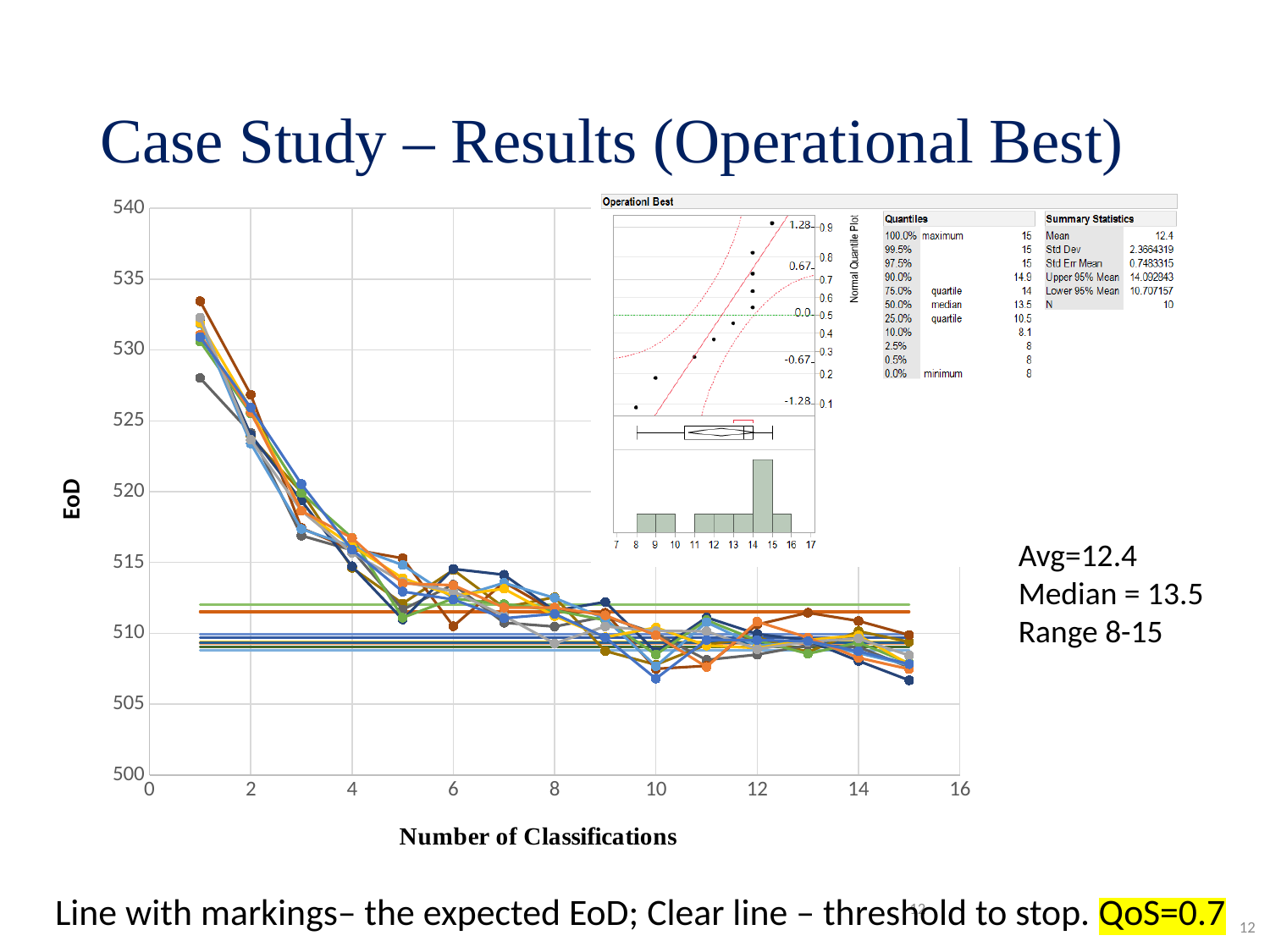
In the main chart, do the plotted EoD lines generally rise or fall as the Number of Classifications increases? fall In the main chart, what is the label of the y axis? EoD In the Operational Best quantiles panel, what is the 100.0% maximum value? 15 In the main chart, are the EoD values at Number of Classifications = 3 greater or less than 515? greater In the main chart, are the EoD values at Number of Classifications = 10 greater or less than 520? less What kind of chart is the main chart plotting EoD against Number of Classifications? line chart In the Operational Best quantiles panel, what is the median (50.0%) value? 13.5 In the main chart, how many Number of Classifications points does each line span, from the first to the last marker? 15 In the main chart, what is the label of the x axis? Number of Classifications In the main chart, are the EoD values at Number of Classifications = 1 greater or less than 525? greater In the Operational Best summary statistics panel, what is the Mean? 12.4